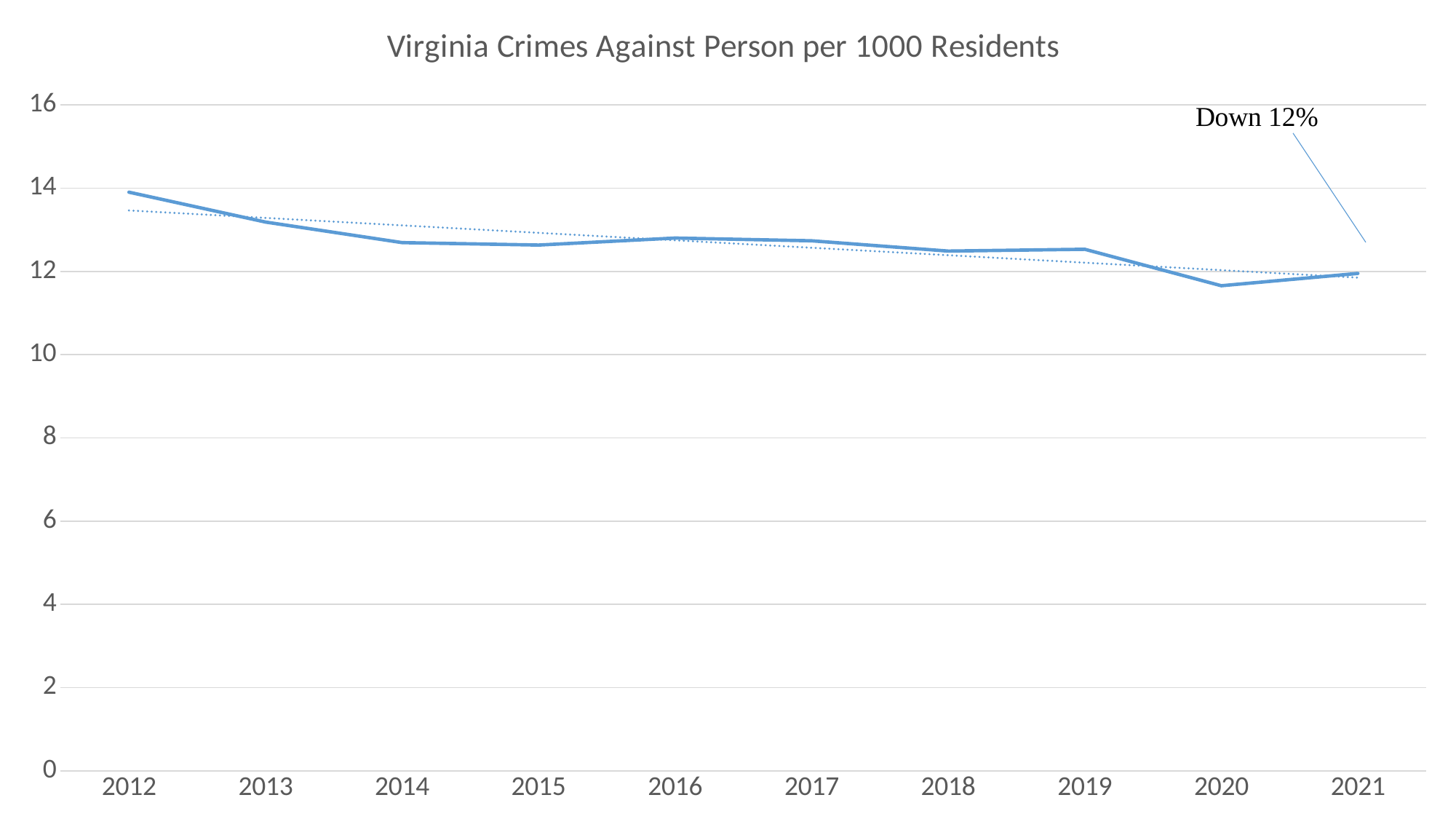
Is the value for 2020 greater or less than 12? less What is the title of the chart? Virginia Crimes Against Person per 1000 Residents What kind of chart is shown on the slide? line chart Which year has the highest value? 2012 How many years are plotted along the x axis? 10 Is the value for 2012 greater or less than 12? greater Which is larger, the value for 2013 or the value for 2018? 2013 Which year has the lowest value? 2020 Which is larger, the value for 2012 or the value for 2020? 2012 Overall, do the values rise or fall from 2012 to 2021? fall What does the annotation near the end of the line say? Down 12%